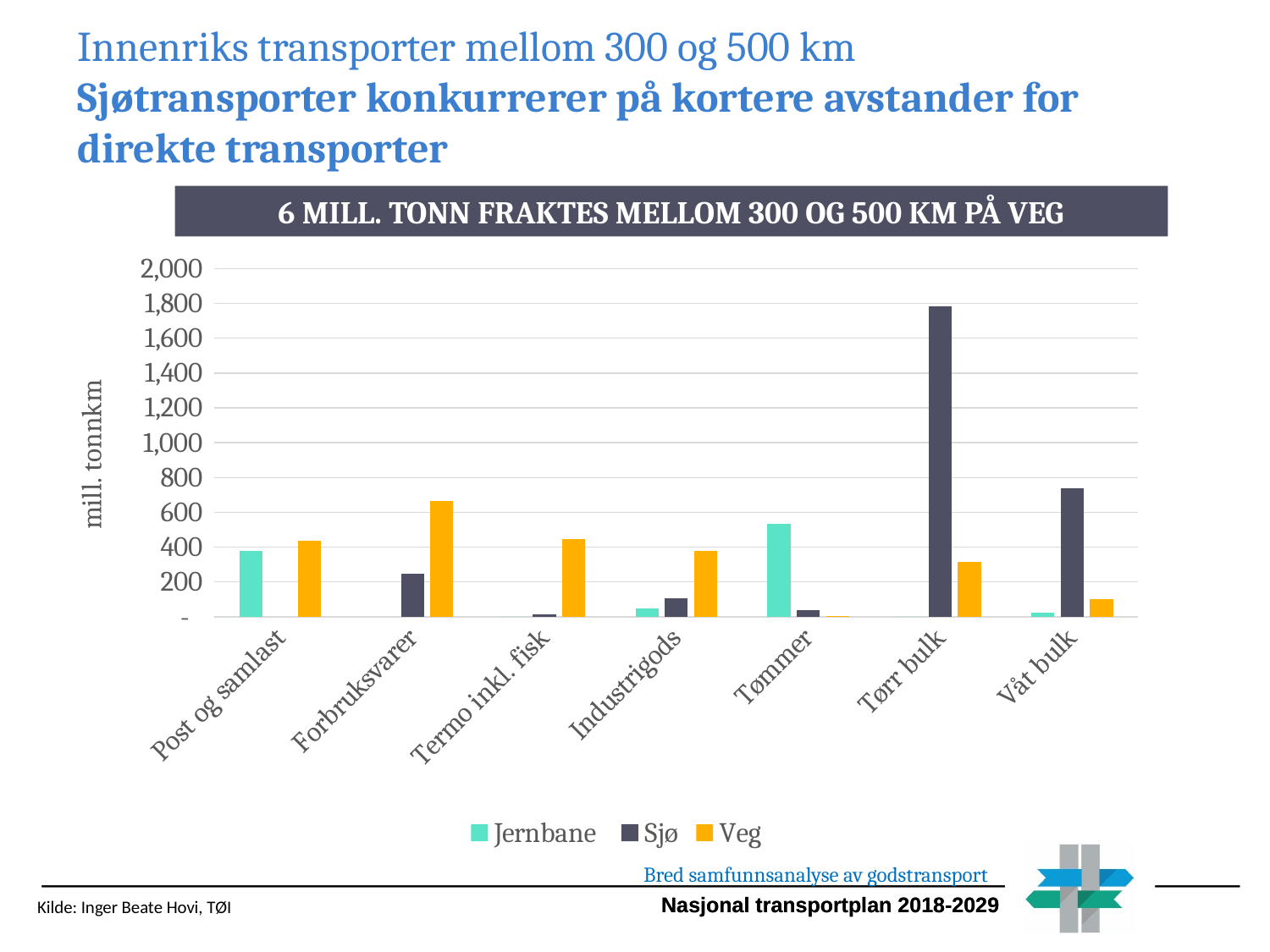
Which category has the highest value for Veg? Forbruksvarer In the Tømmer category, which is larger: Jernbane or Veg? Jernbane Is the value for Veg in Forbruksvarer greater or less than 600? greater Is the value for Sjø in Våt bulk greater or less than 800? less What is the label on the y axis of the chart? mill. tonnkm Is the value for Sjø in Tørr bulk greater or less than 1,600? greater In the Våt bulk category, which is larger: Sjø or Veg? Sjø Which category has the highest value for Jernbane? Tømmer How many categories are shown on the x axis? 7 Which category has the highest value for Sjø? Tørr bulk What kind of chart is shown on the slide? bar chart How many series does the legend list? 3